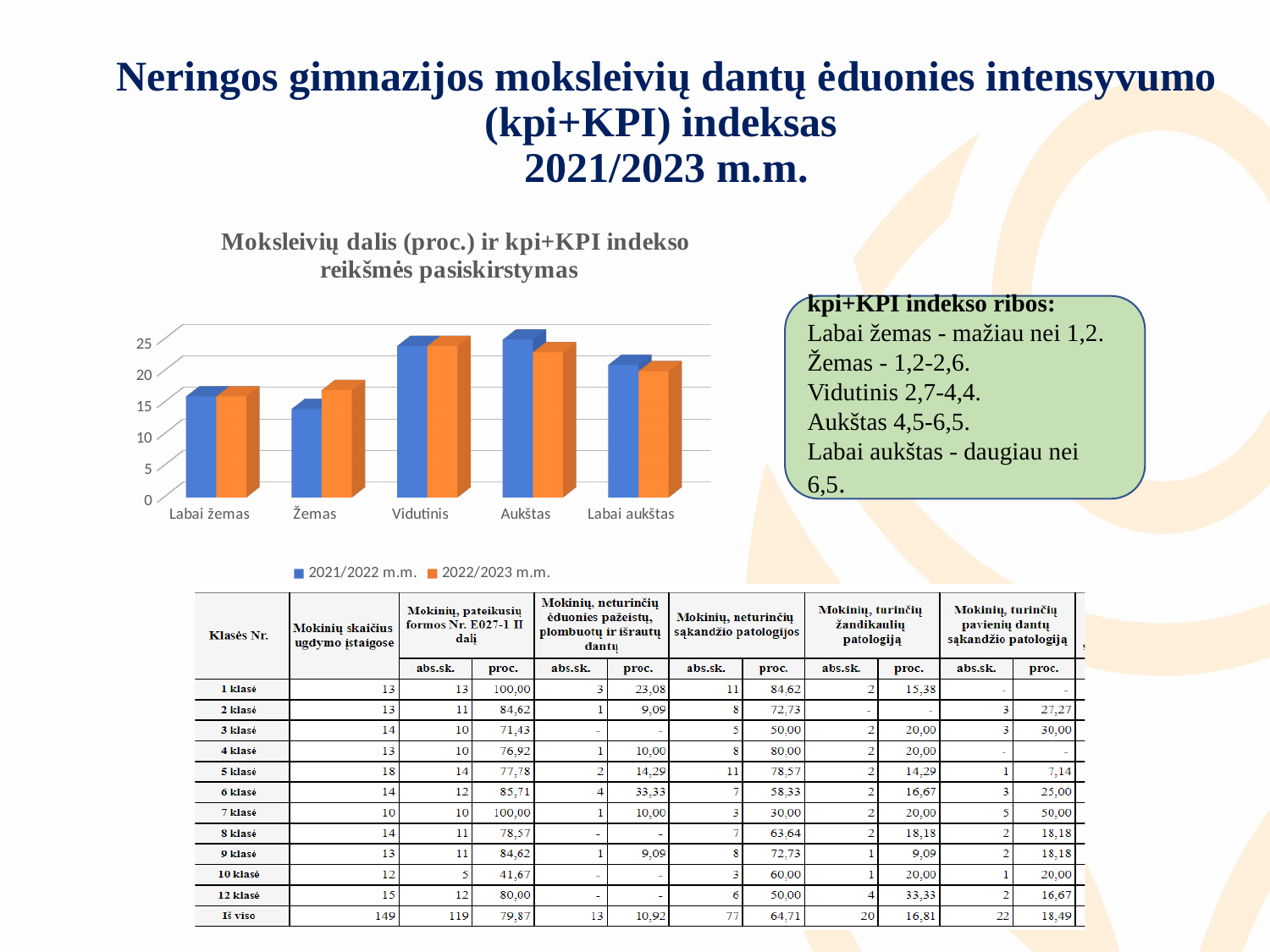
Is the 2021/2022 m.m. value for Žemas greater or less than 10? greater How many series does the chart legend list? 2 What is the title of the chart? Moksleivių dalis (proc.) ir kpi+KPI indekso reikšmės pasiskirstymas Which category has the lowest value for the 2021/2022 m.m. series? Žemas How many categories are shown on the x axis of the chart? 5 What kind of chart is shown on the slide? bar chart Is the 2021/2022 m.m. value for Vidutinis greater or less than 20? greater For the Žemas category, which series has the larger value, 2021/2022 m.m. or 2022/2023 m.m.? 2022/2023 m.m. Which colour represents the 2022/2023 m.m. series in the chart? orange Is the 2022/2023 m.m. value for Labai žemas greater or less than 20? less For the 2021/2022 m.m. series, which category has the larger value, Vidutinis or Žemas? Vidutinis